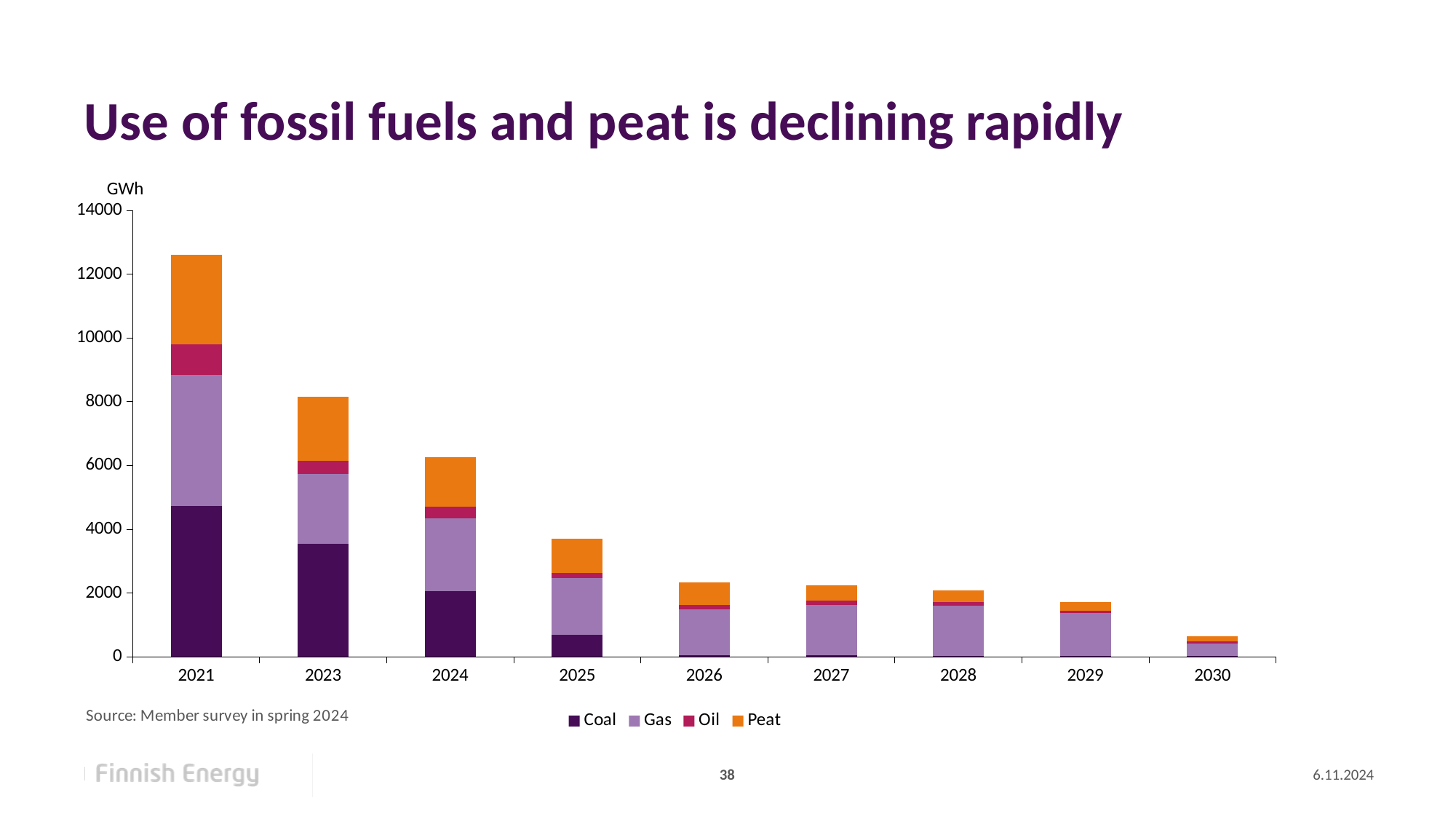
Is the total bar for 2021 greater or less than 12000? greater Which total bar is larger, 2023 or 2024? 2023 How many series does the legend list? 4 Which year has the lowest total bar? 2030 Is the total bar for 2025 greater or less than 4000? less Do the total bars rise or fall from 2021 to 2030? fall What kind of chart is shown on the slide? stacked bar chart Is the total bar for 2030 greater or less than 2000? less How many years are shown on the x axis of the chart? 9 Which year has the highest total bar? 2021 What unit is shown on the y axis of the chart? GWh